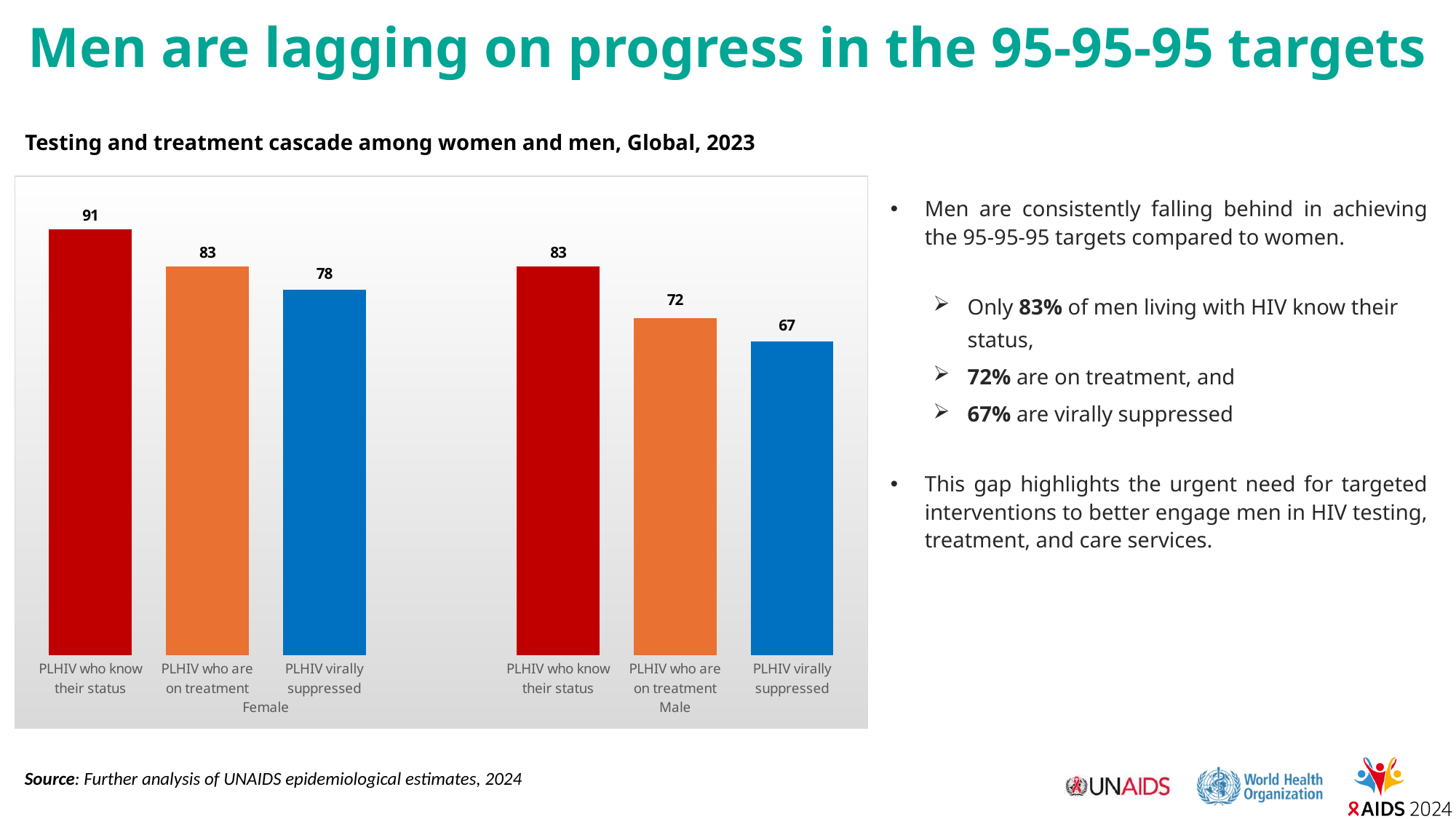
Which bar has the highest value in the chart? PLHIV who know their status (Female) What is the value for PLHIV who are on treatment in the Female group? 83 What is the value for PLHIV who know their status in the Female group? 91 Which is larger: PLHIV who are on treatment for Female or for Male? Female What is the value for PLHIV who are on treatment in the Male group? 72 What is the difference between the Female and Male values for PLHIV who know their status? 8 What is the value for PLHIV virally suppressed in the Male group? 67 What is the title of the chart? Testing and treatment cascade among women and men, Global, 2023 What is the difference between the Female and Male values for PLHIV virally suppressed? 11 How many bars are plotted in the chart? 6 Which bar has the lowest value in the chart? PLHIV virally suppressed (Male) What kind of chart is shown on the slide? Bar chart